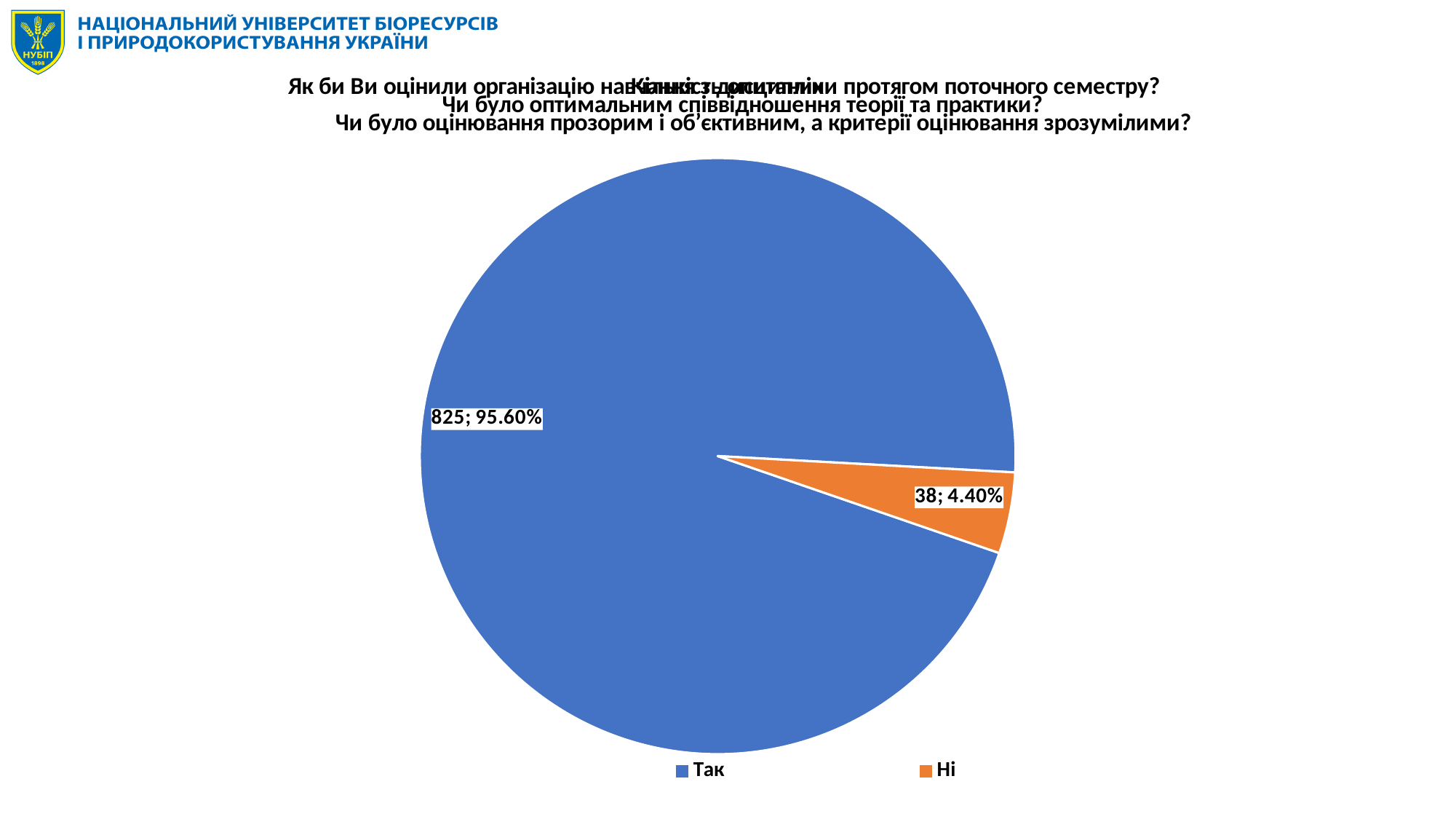
What kind of chart is shown on the slide? pie chart Which slice is the largest? Так How many entries does the legend list? 2 Which slice is the smallest? Ні What is the count shown for the "Ні" slice? 38 What is the difference between the counts for "Так" and "Ні"? 787 How many slices does the pie chart have? 2 What share of the pie does the "Ні" slice represent? 4.40% What colour is the "Ні" slice? orange What share of the pie does the "Так" slice represent? 95.60% Which has a larger count, "Так" or "Ні"? Так What is the count shown for the "Так" slice? 825